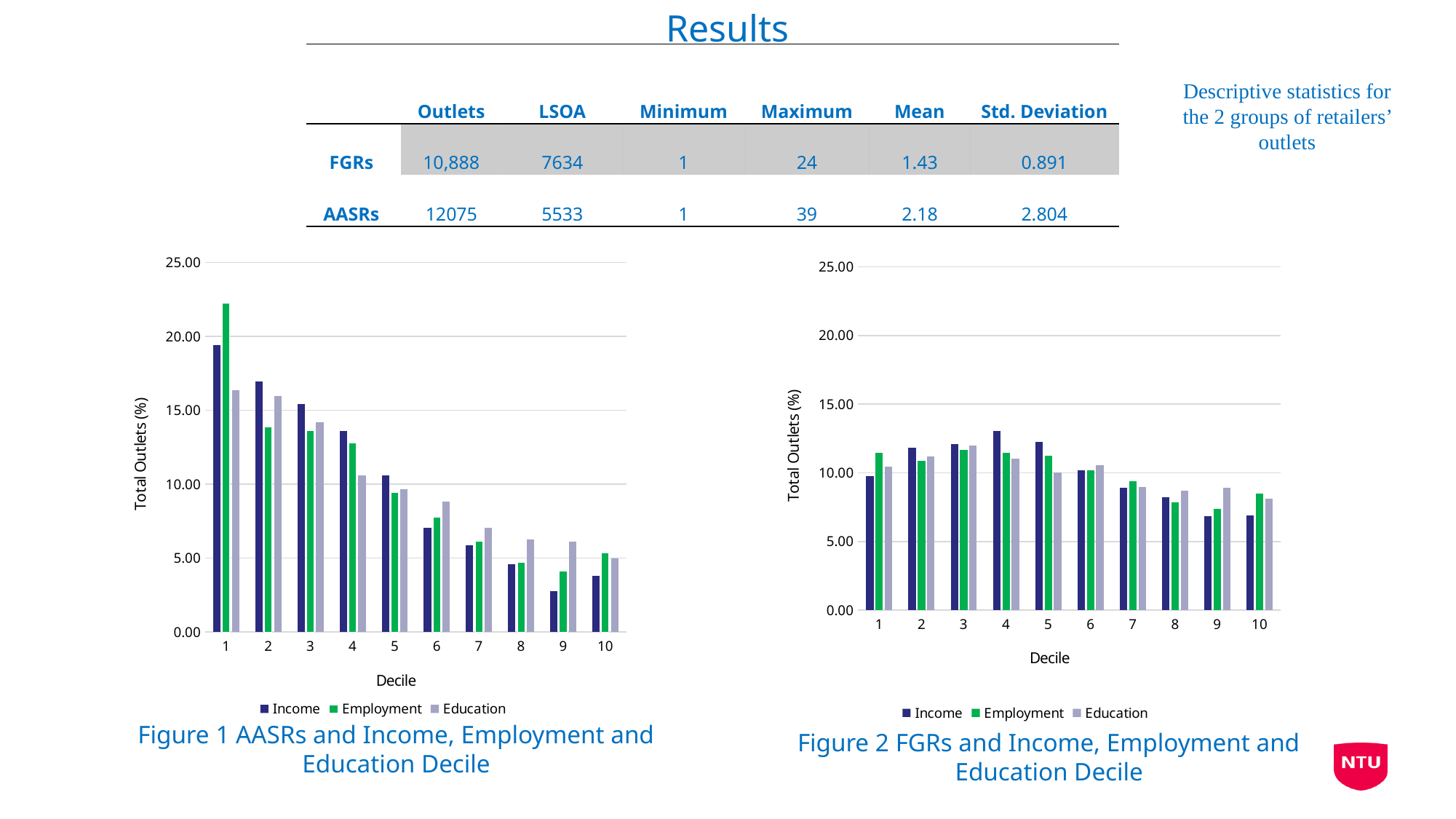
In Figure 1 AASRs and Income, Employment and Education Decile, is the Income value for decile 9 greater or less than 5.00? less In Figure 1 AASRs and Income, Employment and Education Decile, which decile has the lowest Income value? 9 In Figure 2 FGRs and Income, Employment and Education Decile, is the Income value for decile 4 greater or less than 10.00? greater In Figure 2 FGRs and Income, Employment and Education Decile, how many series does the legend list? 3 In Figure 2 FGRs and Income, Employment and Education Decile, which decile has the highest Income value? 4 In Figure 2 FGRs and Income, Employment and Education Decile, for decile 1, which is larger: Income or Employment? Employment In Figure 1 AASRs and Income, Employment and Education Decile, which decile has the highest Employment value? 1 What kind of chart is Figure 1 AASRs and Income, Employment and Education Decile? bar chart In Figure 1 AASRs and Income, Employment and Education Decile, how many deciles are shown on the x axis? 10 In Figure 1 AASRs and Income, Employment and Education Decile, is the Employment value for decile 1 greater or less than 20.00? greater What is the y-axis title of Figure 2 FGRs and Income, Employment and Education Decile? Total Outlets (%) In Figure 1 AASRs and Income, Employment and Education Decile, do the Income values generally rise or fall from decile 1 to decile 10? fall